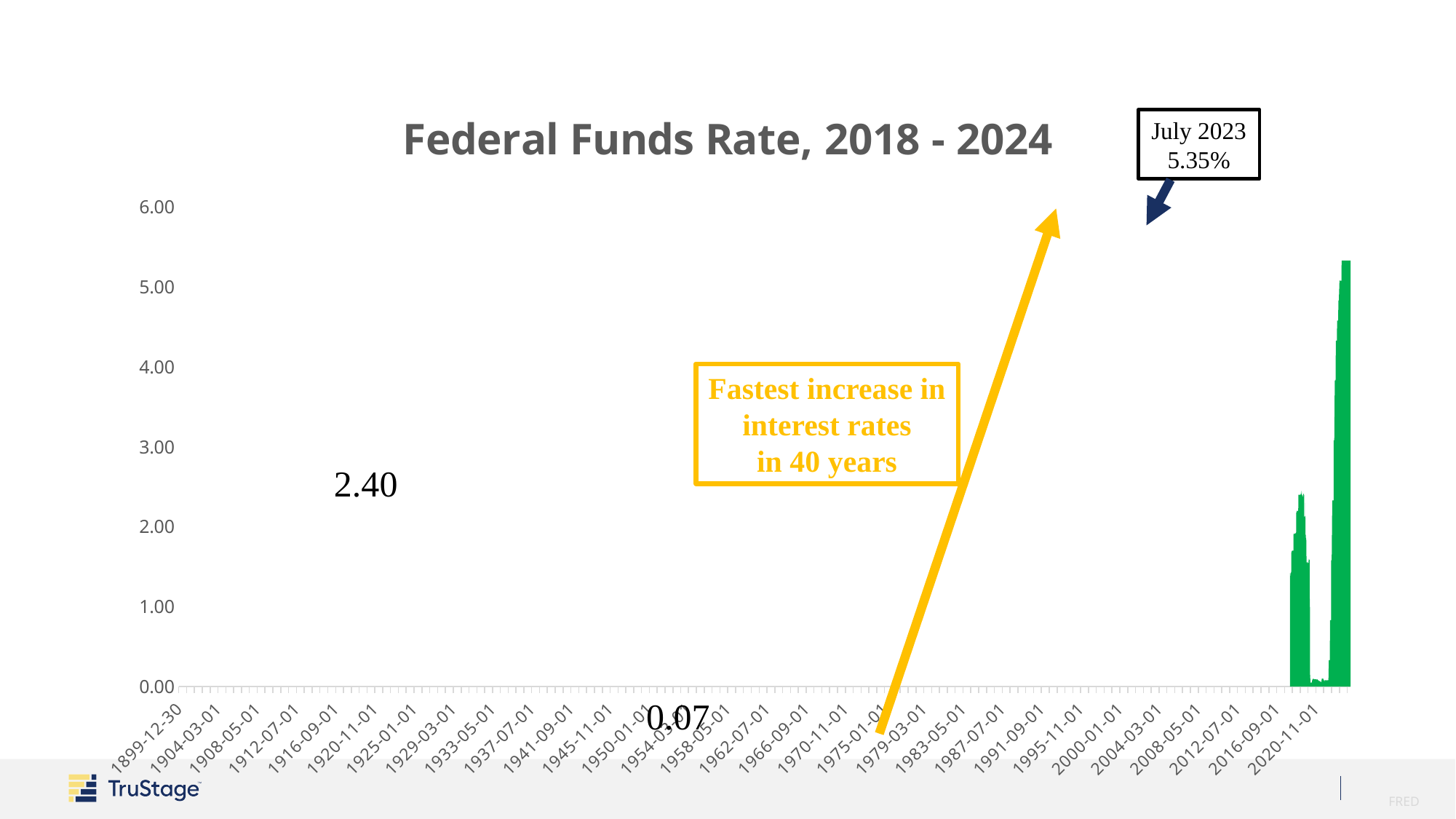
What is the lowest value labelled on the chart? 0.07 What is the difference between the labelled values 2.40 and 0.07? 2.33 What is the highest value labelled on the chart? 5.35% Does the Federal Funds Rate rise or fall from 2022 to July 2023 at the right end of the chart? rise Which is larger, the July 2023 rate of 5.35% or the labelled value of 2.40? 5.35% What Federal Funds Rate is shown for July 2023 in the callout box? 5.35% How much higher is the July 2023 rate (5.35) than the labelled value of 2.40? 2.95 Is the July 2023 rate of 5.35% greater or less than 5.00 on the y axis? greater Is the value labelled 0.07 greater or less than 1.00? less What does the yellow annotation box on the chart say? Fastest increase in interest rates in 40 years Is the value labelled 2.40 greater or less than 2.00? greater What is the title of the chart? Federal Funds Rate, 2018 - 2024